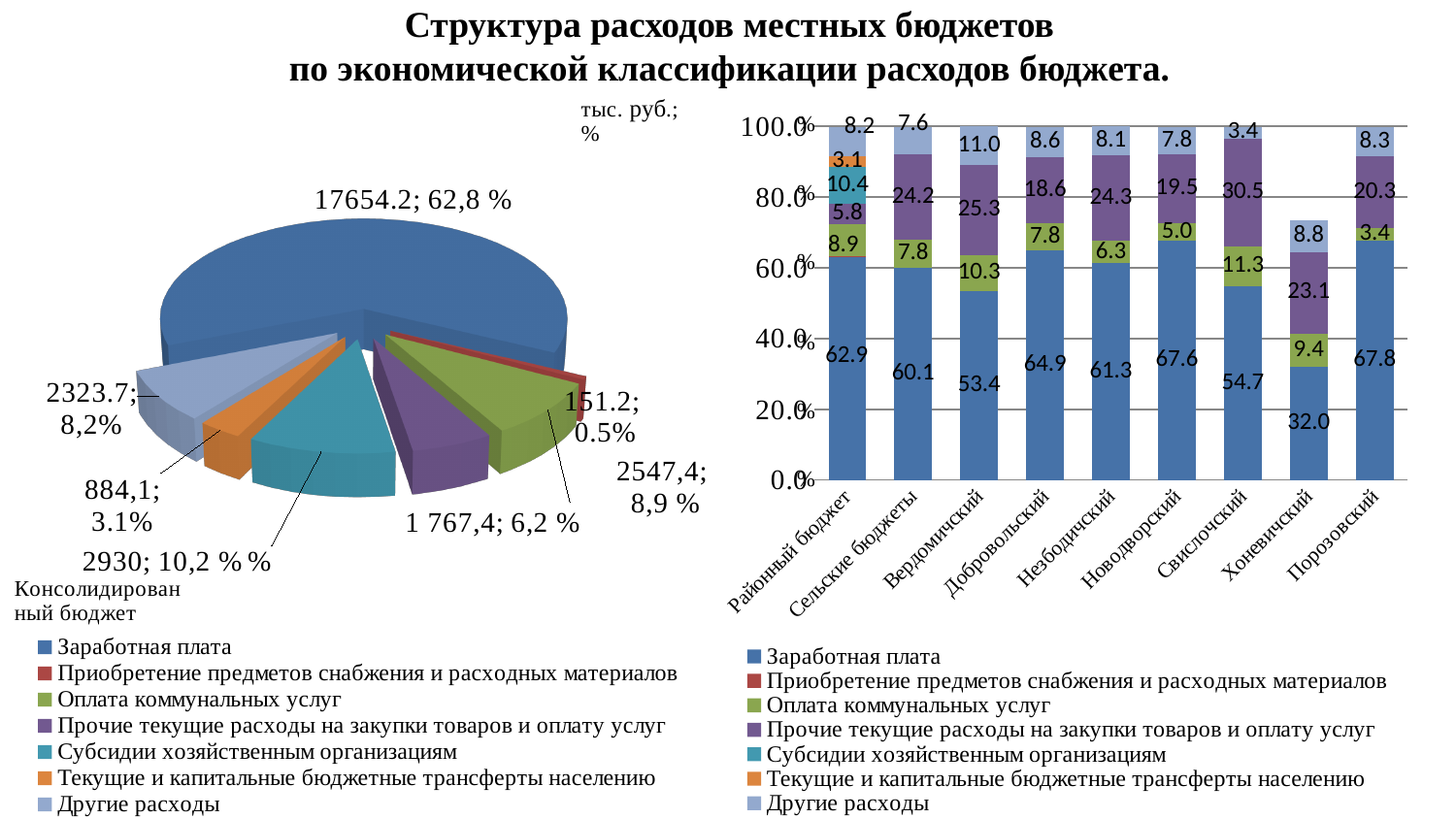
What type of chart is the right chart on the slide? stacked bar chart In the right bar chart, what is the difference between the Заработная плата values for Новодворский and Вердомичский? 14.2 In the right bar chart, which category has the lowest Заработная плата value? Хоневичский In the right bar chart, what is the Заработная плата value for Хоневичский? 32.0 In the left pie chart, what share does the largest slice (Заработная плата) have? 62,8 % In the right bar chart, how many categories are shown on the x axis? 9 In the right bar chart, is the Заработная плата value for Свислочский larger or smaller than that for Добровольский? smaller How many series does the legend of the right bar chart list? 7 In the left pie chart, which category has the smallest slice? Приобретение предметов снабжения и расходных материалов What type of chart is the left chart on the slide? pie chart In the left pie chart, what value is shown for the Субсидии хозяйственным организациям slice? 2930 In the right bar chart, which category has the highest Заработная плата value? Порозовский